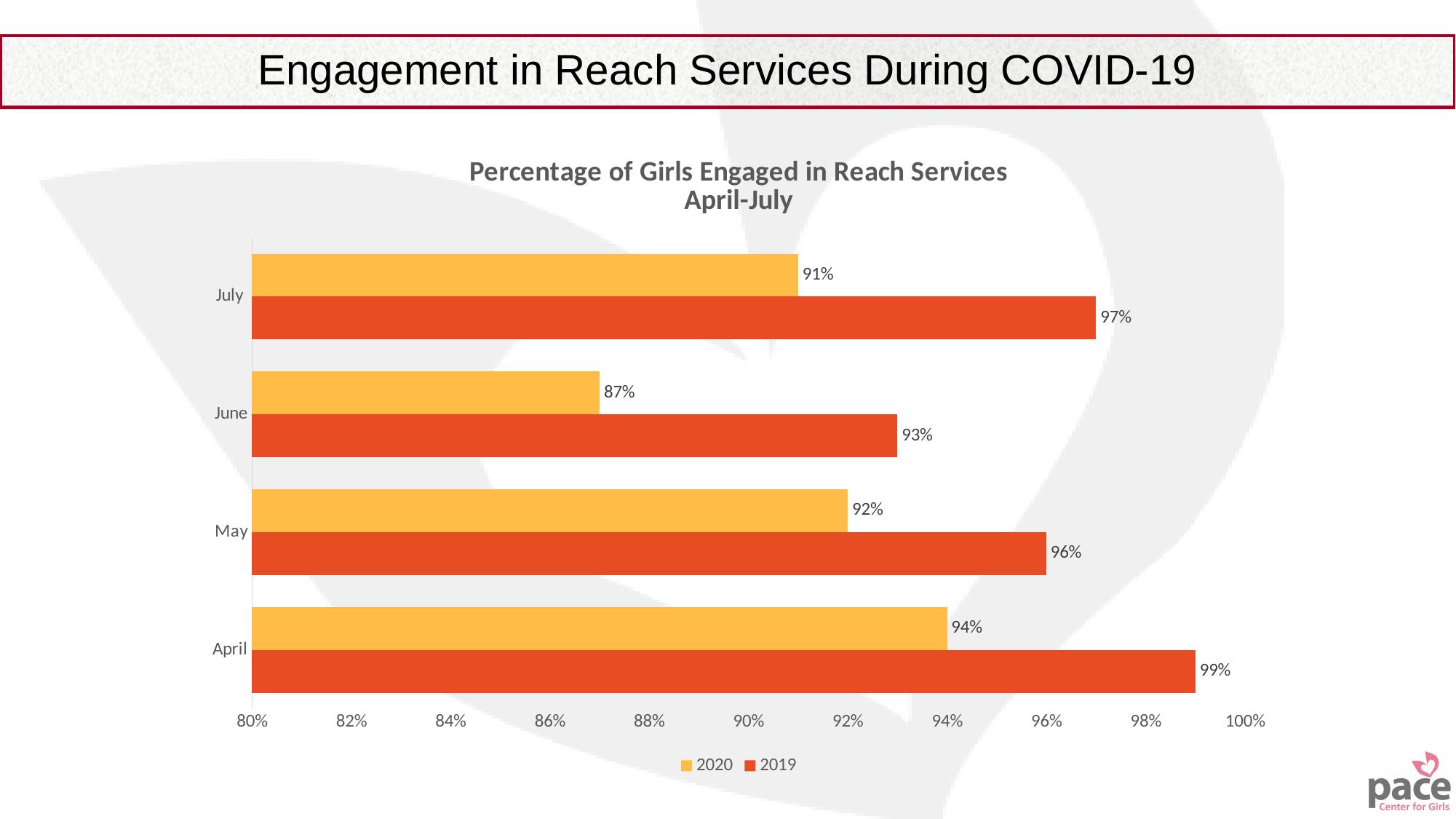
What percentage of girls were engaged in Reach Services in July 2020? 91% Which month had the lowest 2020 engagement percentage? June Which is larger, the 2020 value for April or the 2020 value for May? April What is the title of the chart? Percentage of Girls Engaged in Reach Services April-July Which month had the highest 2019 engagement percentage? April What was the 2020 value for June? 87% What was the 2019 value for April? 99% How many months are shown on the chart? 4 What is the difference between the 2019 and 2020 values for May? 4% What kind of chart is shown on the slide? Bar chart How many series does the legend list? 2 What is the difference between the 2019 and 2020 values for June? 6%